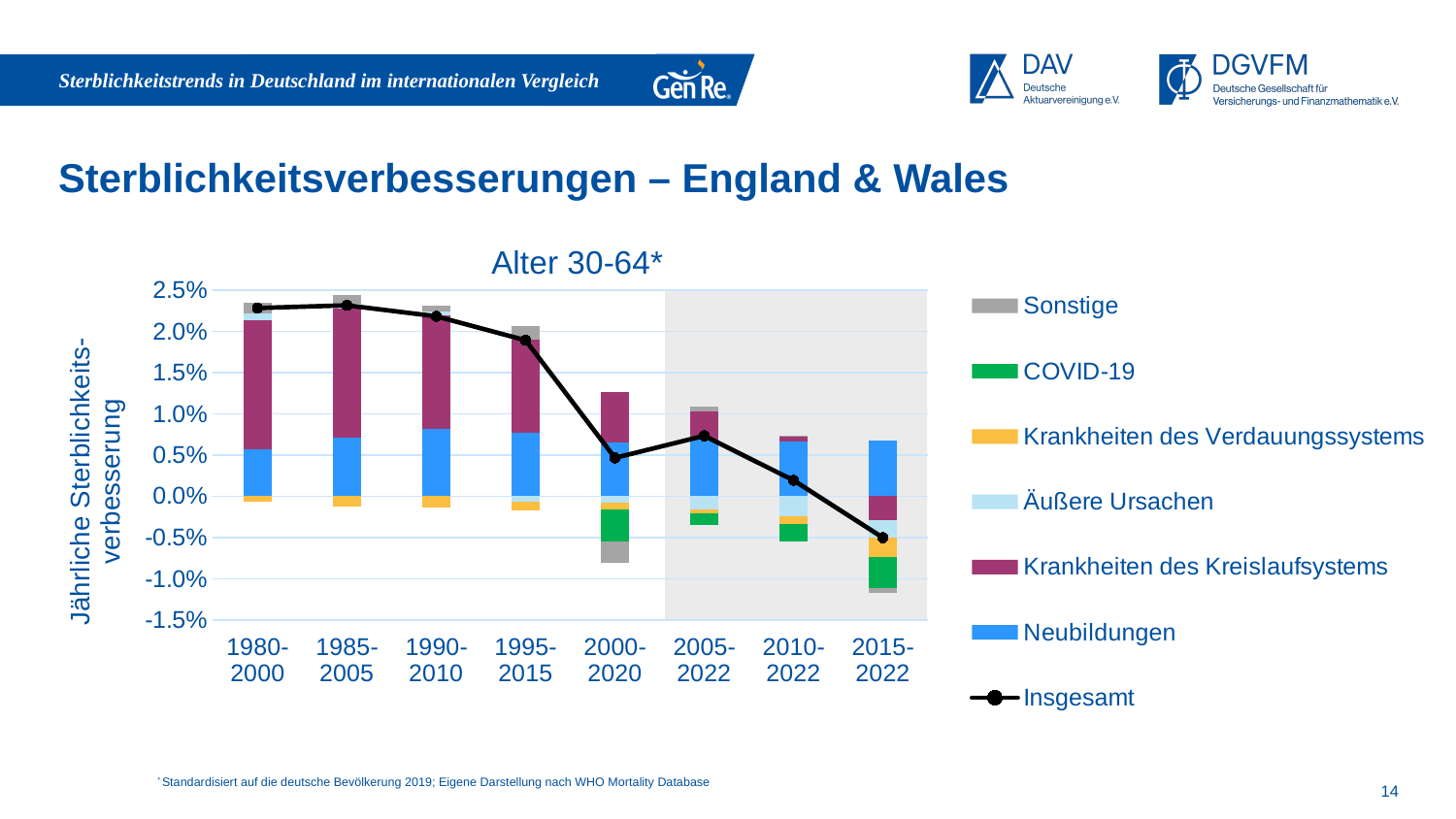
What kind of chart is shown on the slide? combination bar and line chart What is the title of the chart? Alter 30-64* Does the Insgesamt line generally rise or fall from 1980-2000 to 2015-2022? fall Is the Insgesamt value for 1980-2000 greater or less than 2.0%? greater Is the Insgesamt value for 2005-2022 greater or less than 0.5%? greater How many entries does the chart's legend list? 7 Which period has the larger Insgesamt value, 1995-2015 or 2000-2020? 1995-2015 How many time periods are shown on the x axis of the chart? 8 Is the Insgesamt value for 2000-2020 greater or less than 1.0%? less Which colour represents Neubildungen in the chart? blue For which period is the Insgesamt line at its lowest value? 2015-2022